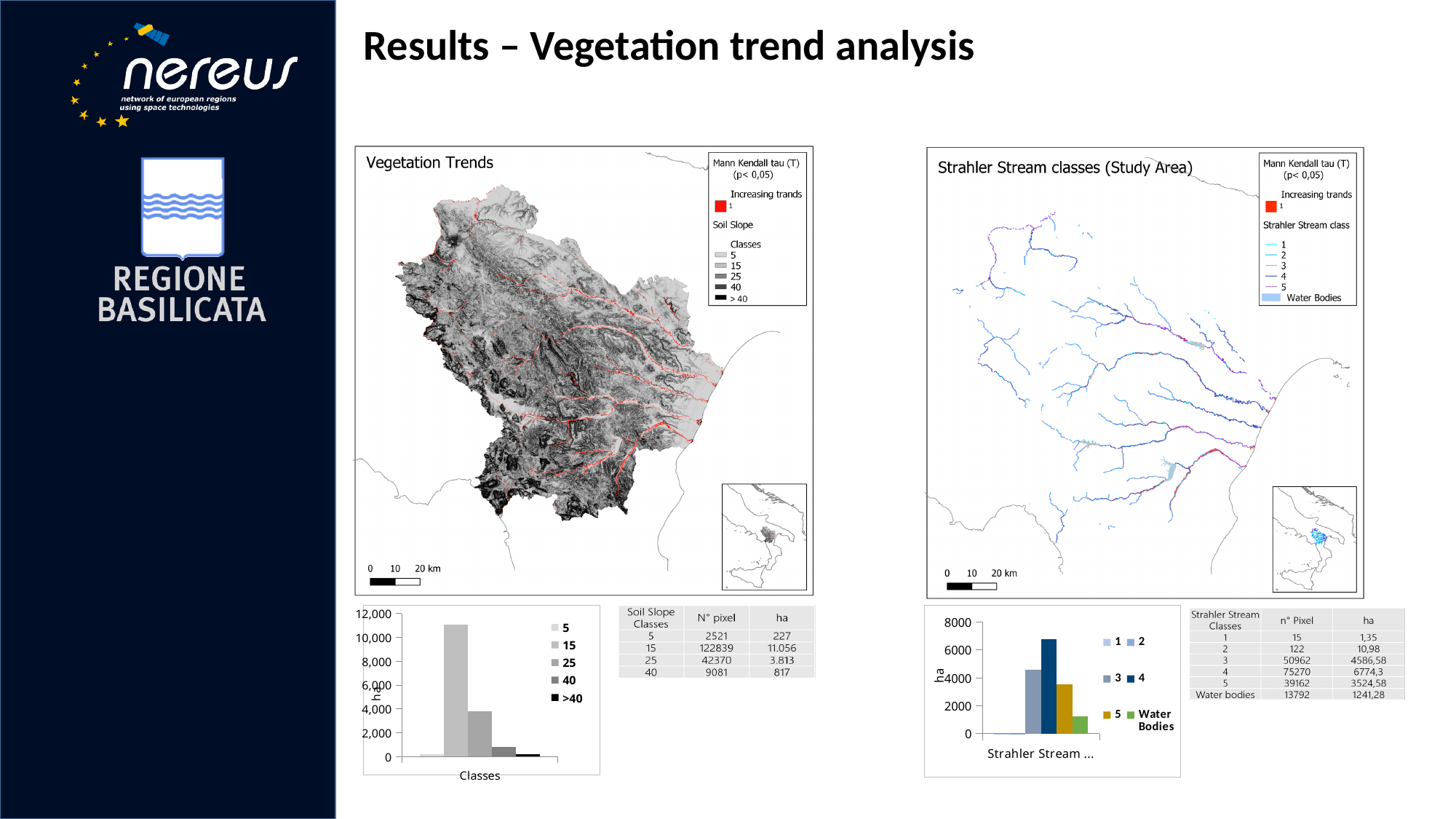
How many entries does the legend of the bottom-right bar chart (Strahler Stream) list? 6 In the bottom-left bar chart (Classes), which class has the highest value? 15 What kind of chart is the chart at the bottom left with the x-axis labelled 'Classes'? bar chart In the bottom-right bar chart (Strahler Stream), which is larger, the value for class 3 or the value for class 5? 3 In the bottom-right bar chart (Strahler Stream), is the value for Water Bodies greater or less than 2000? less In the bottom-left bar chart (Classes), is the value for class 25 greater or less than 6,000? less In the bottom-right bar chart (Strahler Stream), is the value for class 4 greater or less than 6000? greater How many entries does the legend of the bottom-left bar chart (Classes) list? 5 In the bottom-left bar chart (Classes), which is larger, the value for class 25 or the value for class 40? 25 In the bottom-right bar chart (Strahler Stream), which class has the highest value? 4